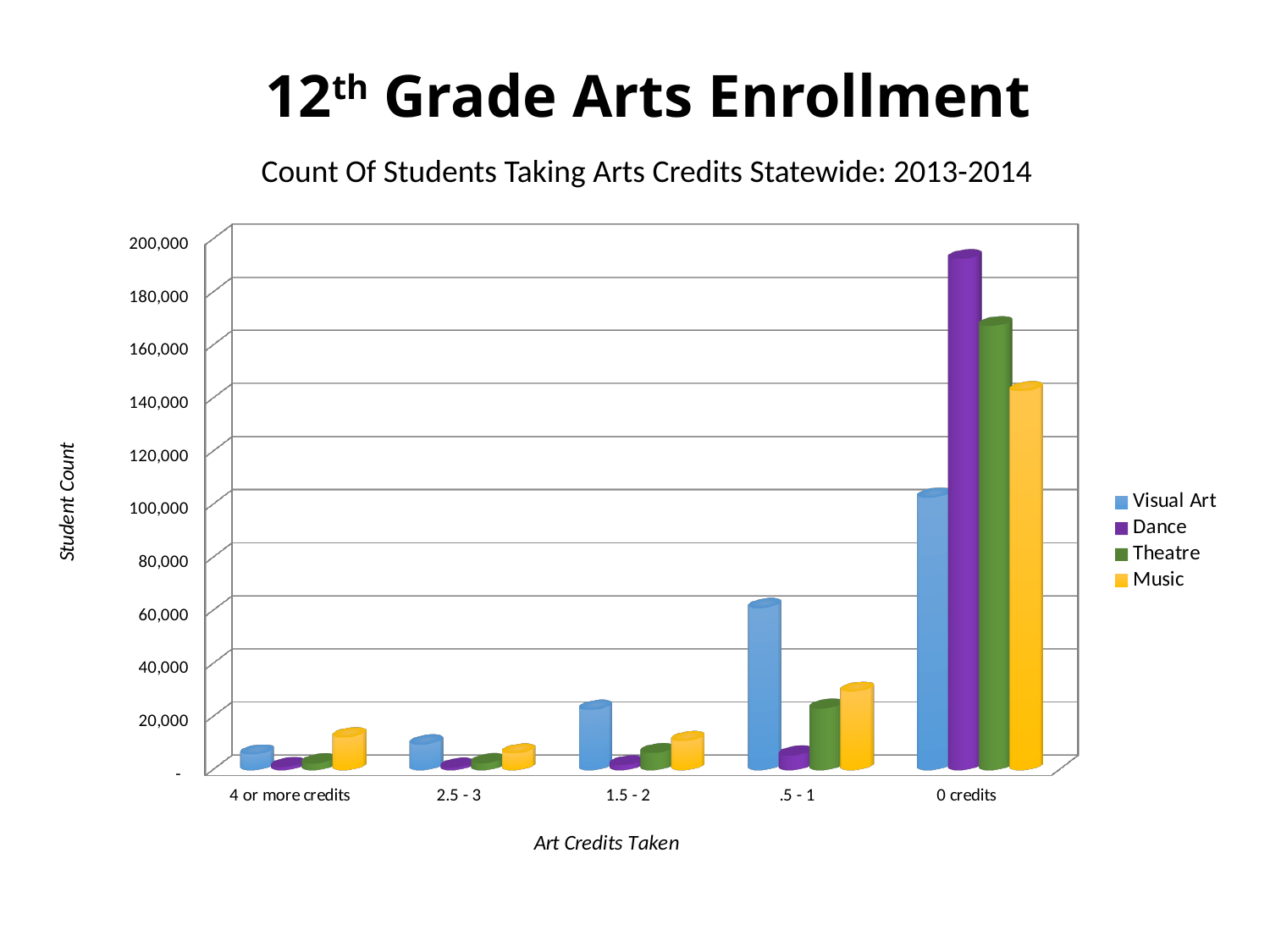
Is the value for Dance in the 0 credits category greater or less than 180,000? greater Is the value for Visual Art in the .5 - 1 category greater or less than 40,000? greater Is the value for Music in the .5 - 1 category greater or less than 40,000? less For Visual Art, which credit category has the highest student count? 0 credits Which series has the highest value in the 0 credits category? Dance Which series has the lowest value in the 0 credits category? Visual Art In the .5 - 1 category, which is larger, Visual Art or Music? Visual Art How many series does the legend list? 4 What kind of chart is shown on the slide? bar chart How many credit categories are shown on the x axis? 5 What is the title of the vertical axis? Student Count